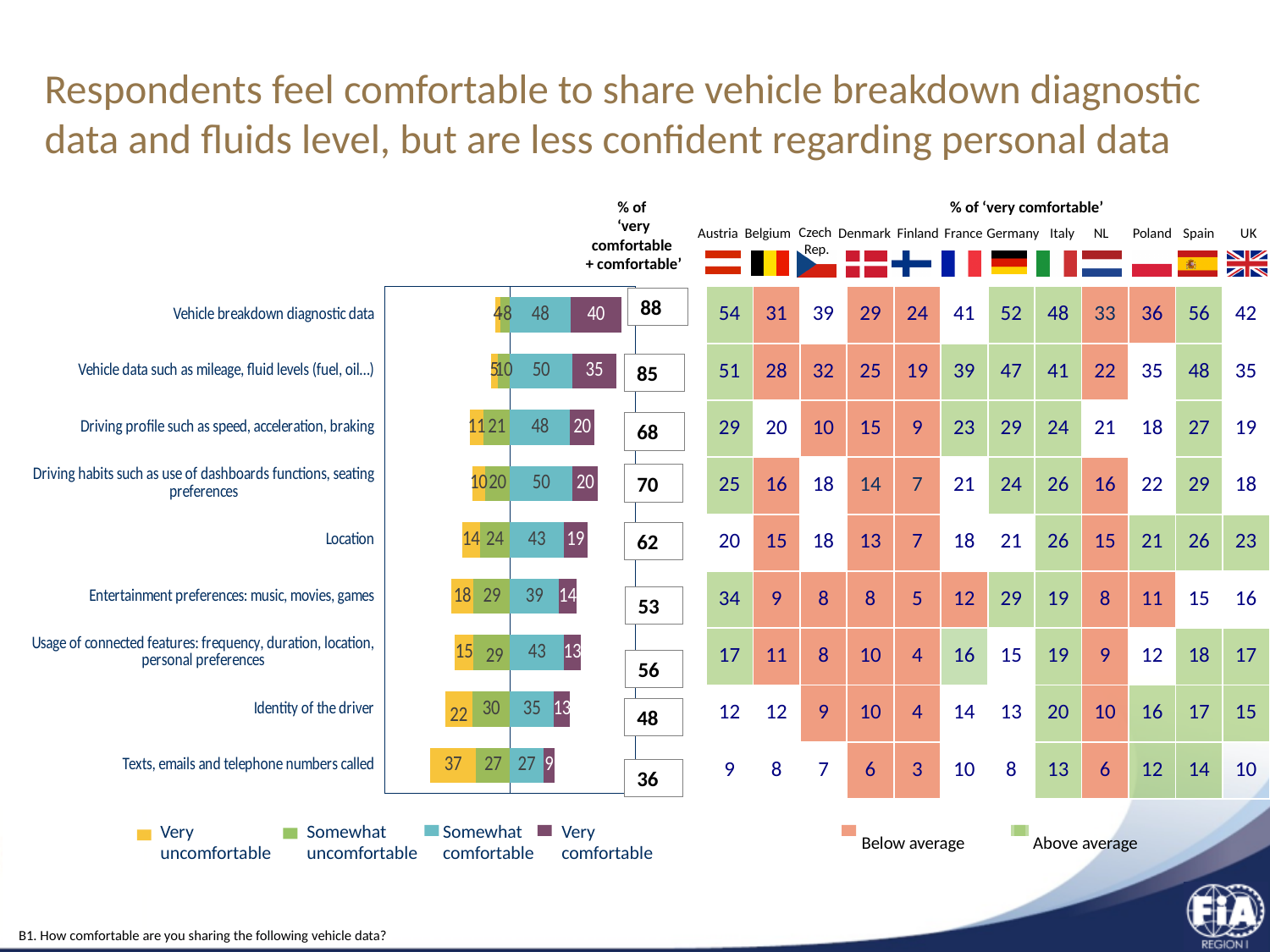
In the country table of '% of very comfortable', what is the value for Spain for 'Vehicle breakdown diagnostic data'? 56 In the stacked bar chart, what is the 'Very uncomfortable' value for 'Texts, emails and telephone numbers called'? 37 What kind of chart is used to show the comfort levels for sharing each type of vehicle data? bar chart In the stacked bar chart, what is the 'Very comfortable' value for 'Vehicle breakdown diagnostic data'? 40 Which category has the lowest 'Very comfortable' value in the stacked bar chart? Texts, emails and telephone numbers called How many data categories are listed on the stacked bar chart? 9 Which has the larger 'Somewhat comfortable' value: 'Location' or 'Identity of the driver'? Location How many series does the legend of the stacked bar chart list? 4 What is the '% of very comfortable + comfortable' value shown for 'Identity of the driver'? 48 In the stacked bar chart, what is the 'Somewhat comfortable' value for 'Vehicle data such as mileage, fluid levels (fuel, oil…)'? 50 What is the difference between the 'Very comfortable' values for 'Vehicle breakdown diagnostic data' and 'Location'? 21 Which category has the highest 'Very comfortable' value in the stacked bar chart? Vehicle breakdown diagnostic data